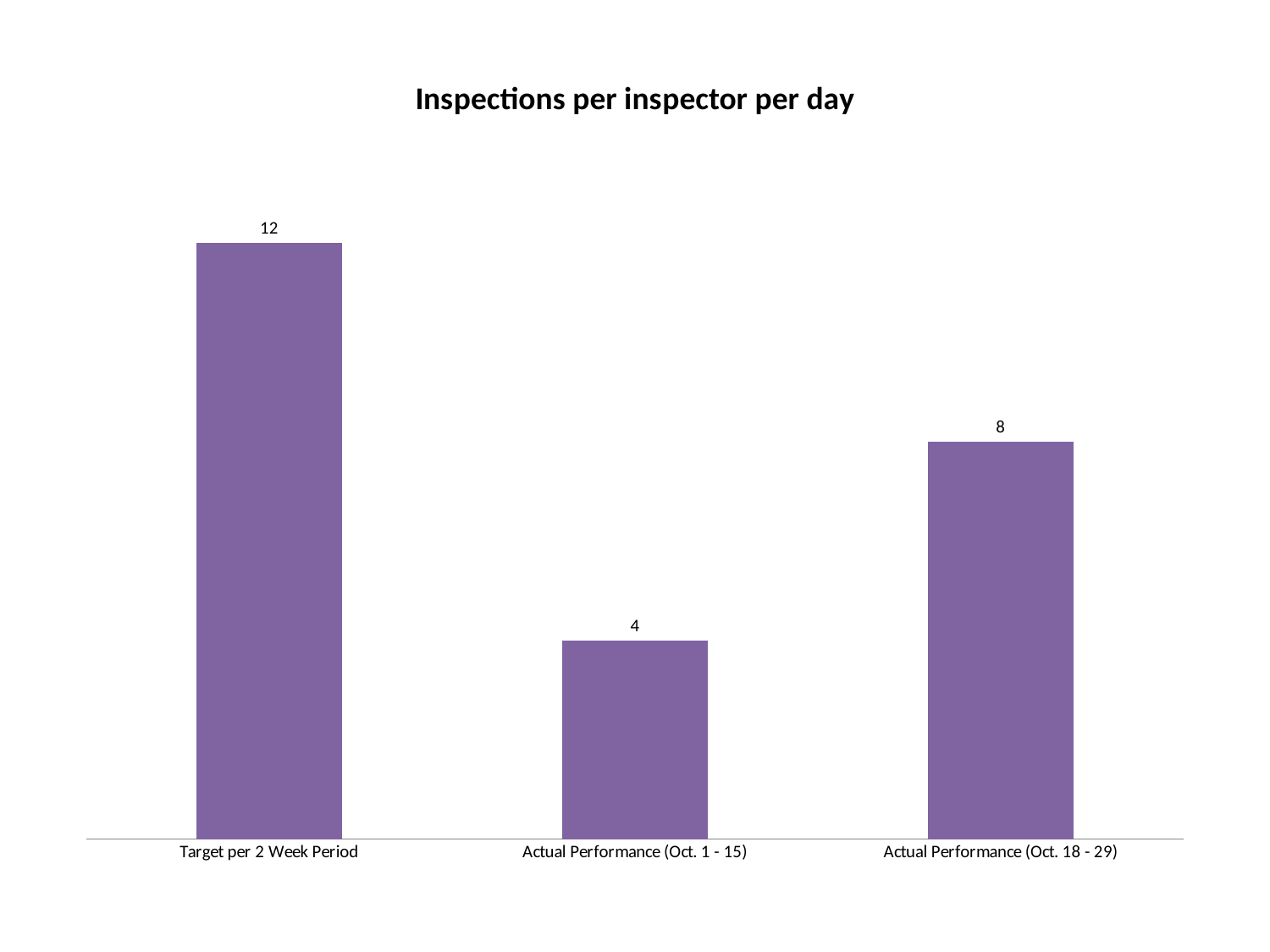
What colour are the bars in the chart? Purple What is the difference between Actual Performance (Oct. 18 - 29) and Actual Performance (Oct. 1 - 15)? 4 Which category has the highest value? Target per 2 Week Period What kind of chart is shown on the slide? Bar chart What is the value for Target per 2 Week Period? 12 What is the title of the chart? Inspections per inspector per day How many categories are shown in the chart? 3 What is the value for Actual Performance (Oct. 1 - 15)? 4 What is the difference between Target per 2 Week Period and Actual Performance (Oct. 18 - 29)? 4 Which is larger, Actual Performance (Oct. 1 - 15) or Actual Performance (Oct. 18 - 29)? Actual Performance (Oct. 18 - 29) Which category has the lowest value? Actual Performance (Oct. 1 - 15) What is the value for Actual Performance (Oct. 18 - 29)? 8